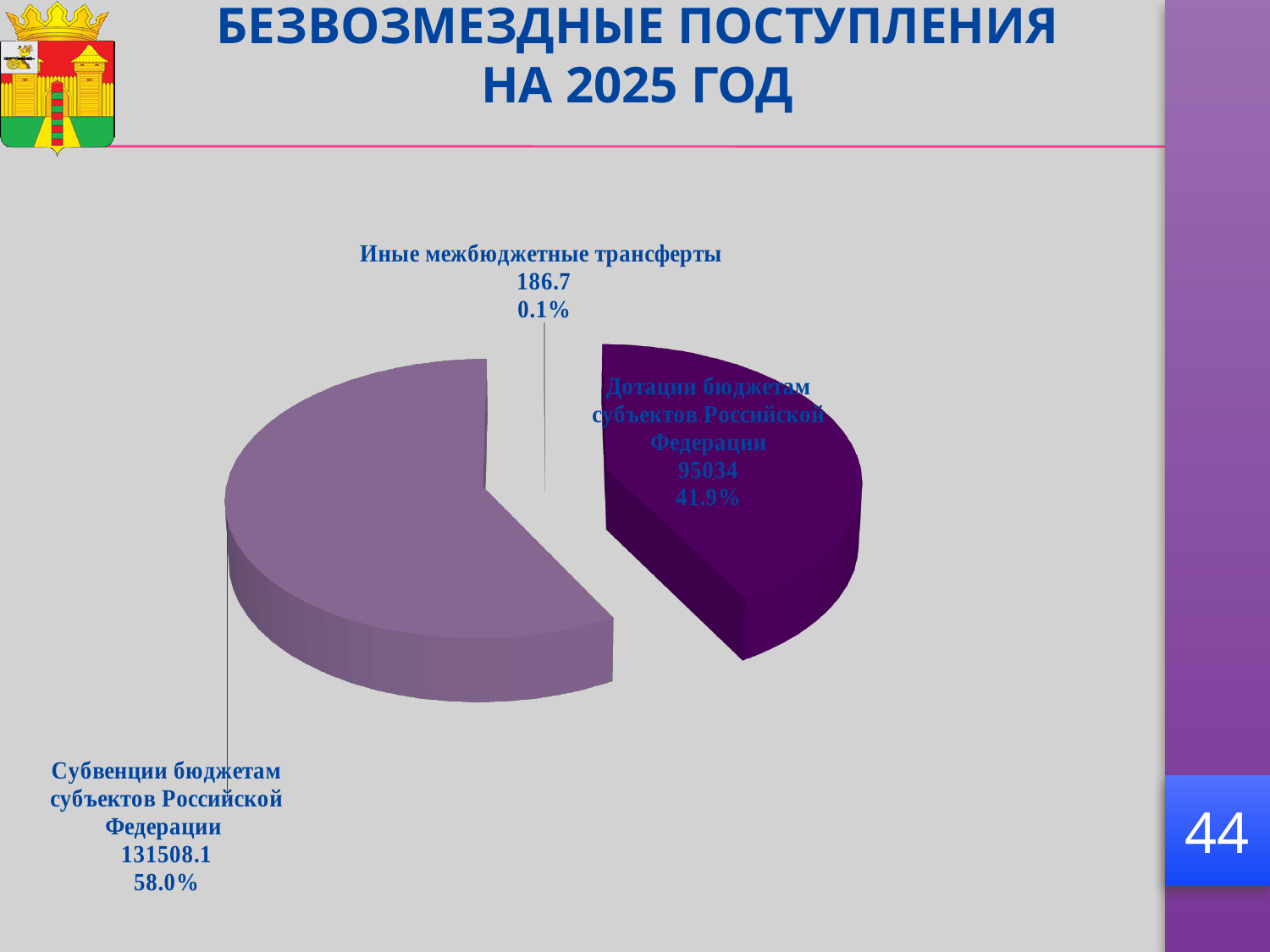
What is the value for Дотации бюджетам субъектов Российской Федерации? 95034 How many categories are shown in the pie chart? 3 What is the title of the slide containing the chart? БЕЗВОЗМЕЗДНЫЕ ПОСТУПЛЕНИЯ НА 2025 ГОД Which category has the smallest slice of the pie? Иные межбюджетные трансферты What kind of chart is shown on the slide? pie chart Which category has the largest slice of the pie? Субвенции бюджетам субъектов Российской Федерации What share of the pie does Дотации бюджетам субъектов Российской Федерации represent? 41.9% What is the value for Субвенции бюджетам субъектов Российской Федерации? 131508.1 What is the difference between the values for Субвенции бюджетам субъектов Российской Федерации and Дотации бюджетам субъектов Российской Федерации? 36474.1 What share of the pie does Иные межбюджетные трансферты represent? 0.1% What is the value for Иные межбюджетные трансферты? 186.7 What share of the pie does Субвенции бюджетам субъектов Российской Федерации represent? 58.0%